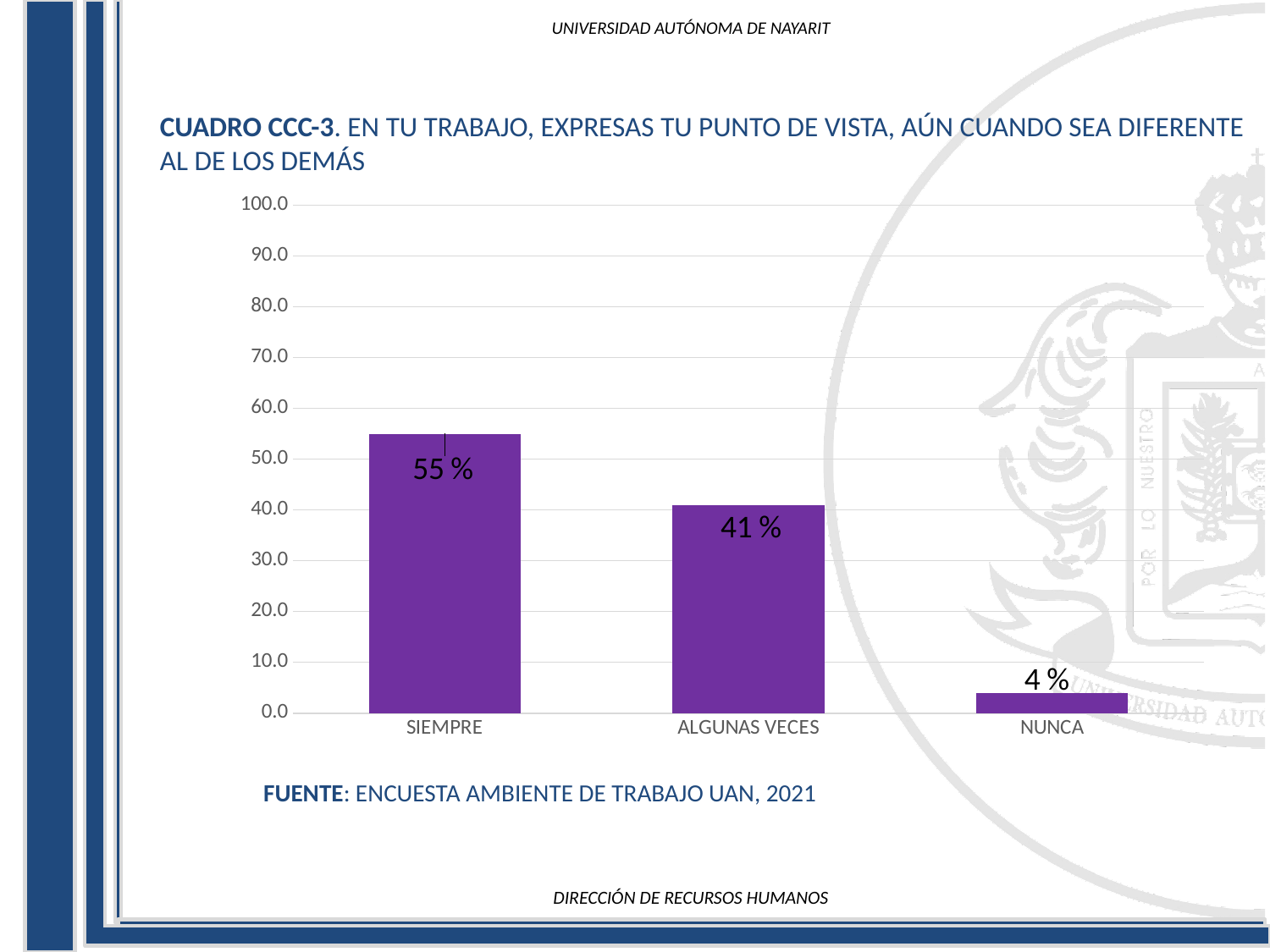
What is the difference between the values for ALGUNAS VECES and NUNCA? 37 % What is the difference between the values for SIEMPRE and ALGUNAS VECES? 14 % How many categories are shown on the x axis? 3 Which category has the lowest value? NUNCA What is the value for NUNCA? 4 % Is the value for ALGUNAS VECES greater or less than 50.0? less Which is larger, the value for SIEMPRE or the value for ALGUNAS VECES? SIEMPRE What is the value for SIEMPRE? 55 % Which category has the highest value? SIEMPRE Do the values rise or fall from left to right along the x axis? fall What kind of chart is shown on the slide? bar chart What is the value for ALGUNAS VECES? 41 %